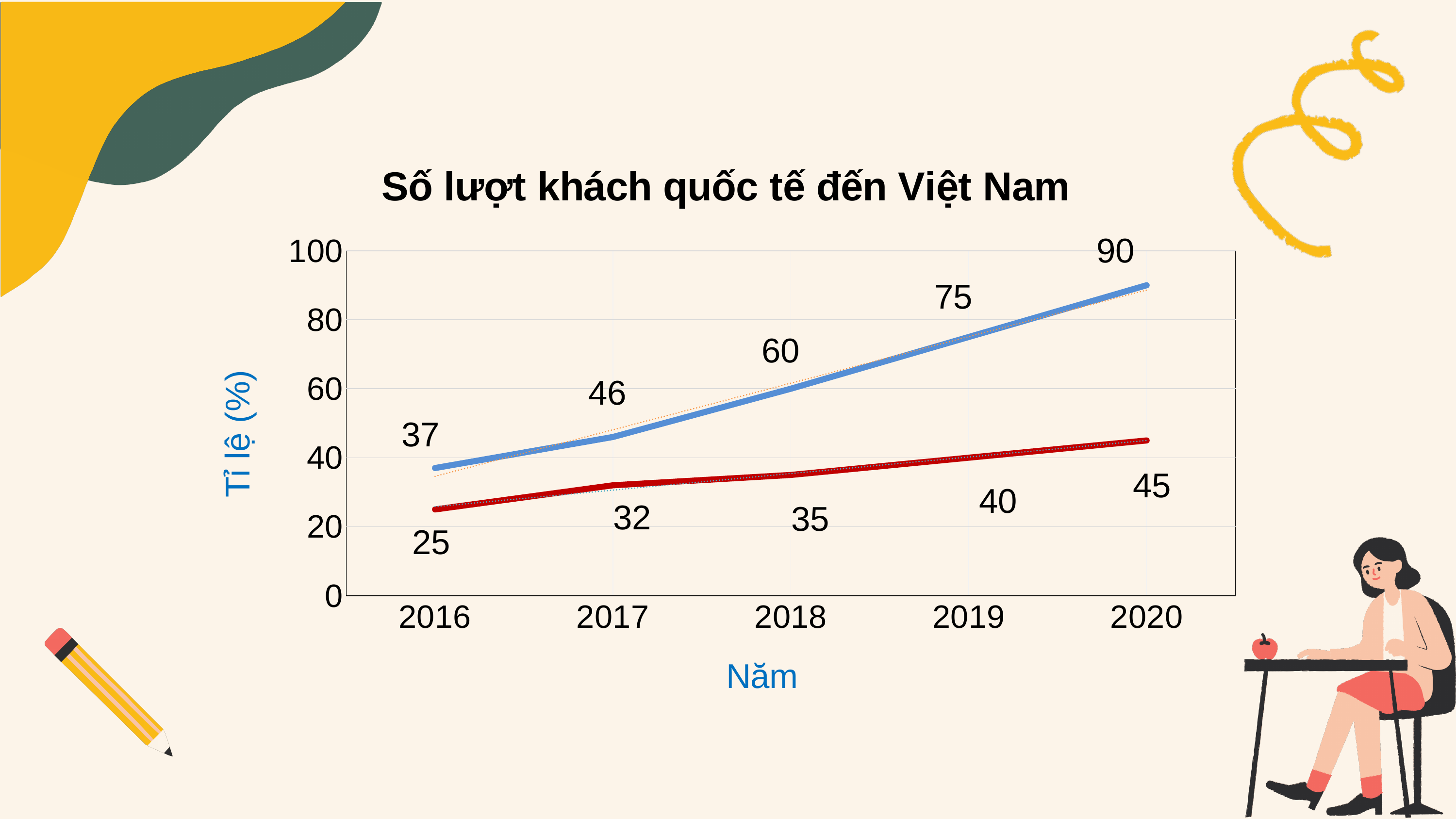
What is the difference between the blue line and the red line in 2020? 45 Which line has the higher value in 2017, the blue line or the red line? The blue line Does the red line rise or fall from 2016 to 2020? Rises In which year does the blue line reach its highest value? 2020 What is the label of the vertical axis? Tỉ lệ (%) What type of chart is shown on the slide? Line chart How many years are shown on the x axis? 5 What is the value of the red line in 2019? 40 What is the title of the chart? Số lượt khách quốc tế đến Việt Nam What is the value of the blue line in 2018? 60 In which year does the red line have its lowest value? 2016 What is the value of the blue line in 2016? 37